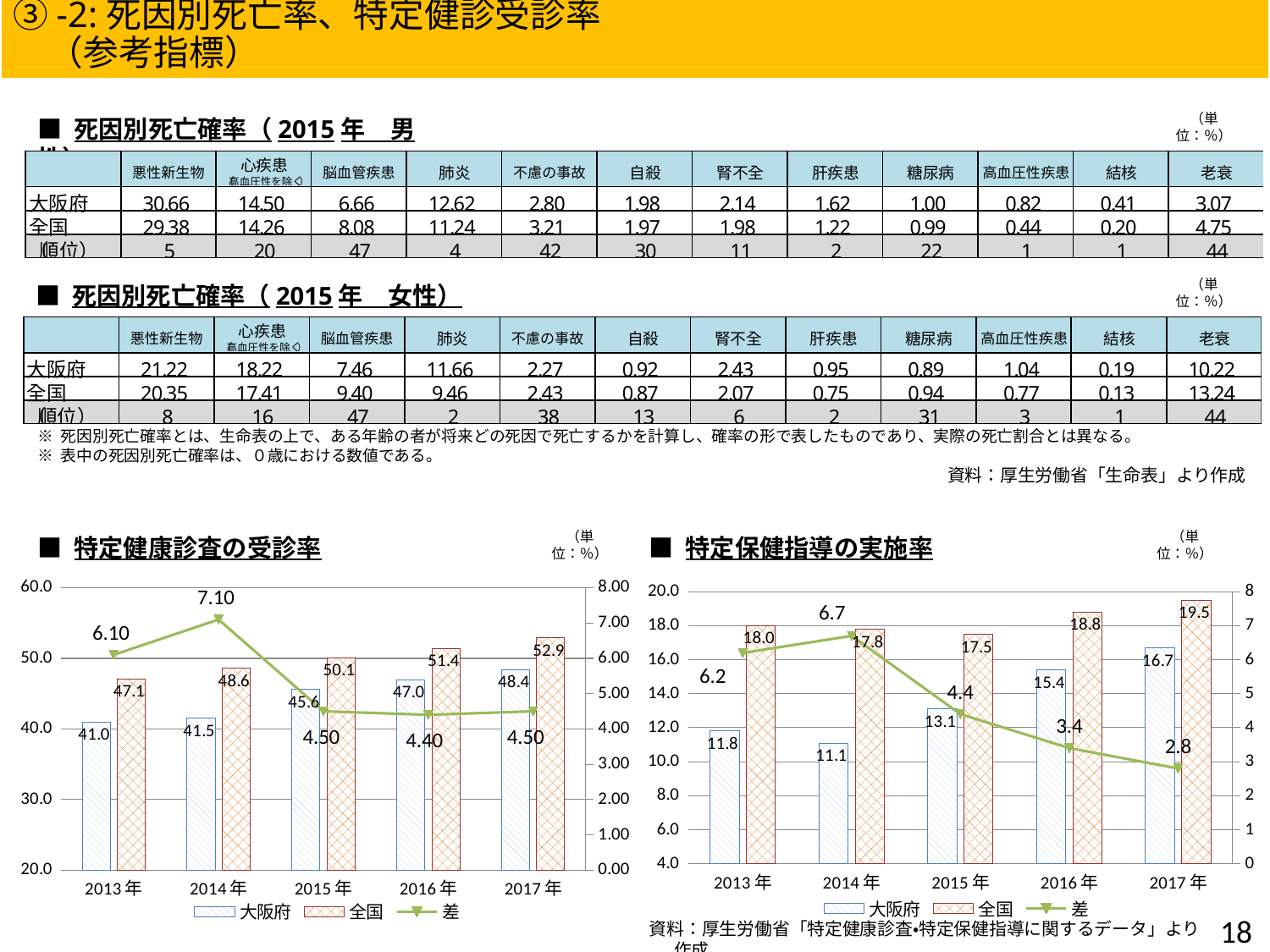
In the 特定保健指導の実施率 chart (bottom right), what is the value for 全国 in 2016年? 18.8 In the 特定健康診査の受診率 chart (bottom left), what is the difference between the 全国 and 大阪府 values in 2013年? 6.10 In the 特定保健指導の実施率 chart (bottom right), how many years are shown on the x axis? 5 In the 特定健康診査の受診率 chart (bottom left), does the 大阪府 value rise or fall from 2013年 to 2017年? rise In the 特定保健指導の実施率 chart (bottom right), which is larger in 2015年, 大阪府 or 全国? 全国 In the 特定保健指導の実施率 chart (bottom right), in which year is the 大阪府 value lowest? 2014年 In the 特定健康診査の受診率 chart (bottom left), what is the value for 大阪府 in 2017年? 48.4 In the 特定健康診査の受診率 chart (bottom left), in which year is the 全国 value highest? 2017年 In the 特定保健指導の実施率 chart (bottom right), what is the value of 差 in 2017年? 2.8 In the 特定健康診査の受診率 chart (bottom left), how many series does the legend list? 3 In the 特定健康診査の受診率 chart (bottom left), what is the value of 差 in 2014年? 7.10 In the 特定保健指導の実施率 chart (bottom right), does the 差 line rise or fall from 2014年 to 2017年? fall